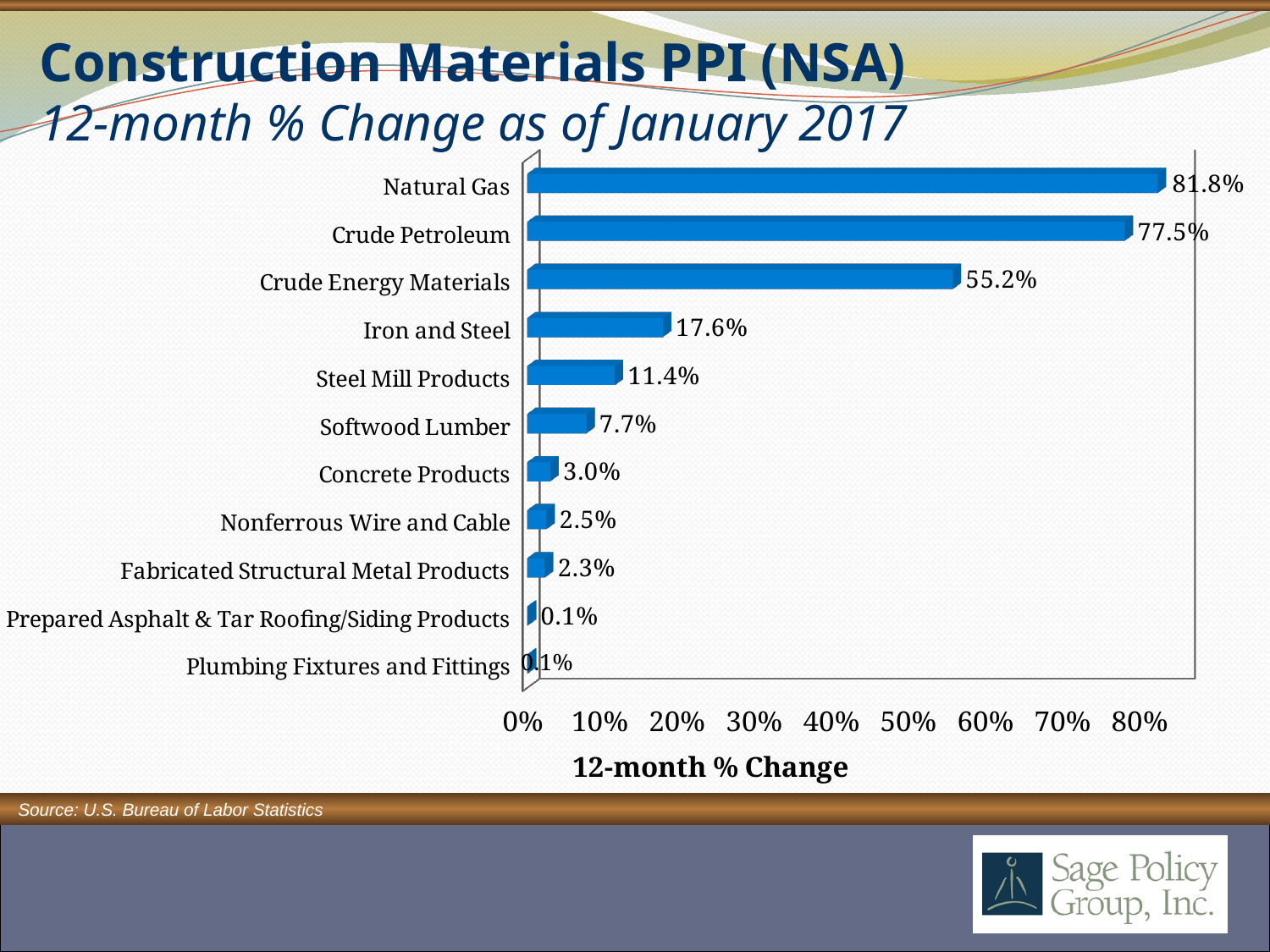
What is the label on the horizontal axis of the chart? 12-month % Change Is the value for Crude Petroleum greater or less than 70%? greater What is the difference between the 12-month % change for Iron and Steel and Steel Mill Products? 6.2% What is the 12-month % change for Natural Gas? 81.8% What is the 12-month % change for Softwood Lumber? 7.7% What is the 12-month % change for Crude Energy Materials? 55.2% What is the difference between the 12-month % change for Natural Gas and Crude Petroleum? 4.3% What is the 12-month % change for Fabricated Structural Metal Products? 2.3% What kind of chart is shown on the slide? Bar chart How many categories are shown in the chart? 11 Which category has the highest 12-month % change? Natural Gas Which has a larger 12-month % change, Concrete Products or Nonferrous Wire and Cable? Concrete Products